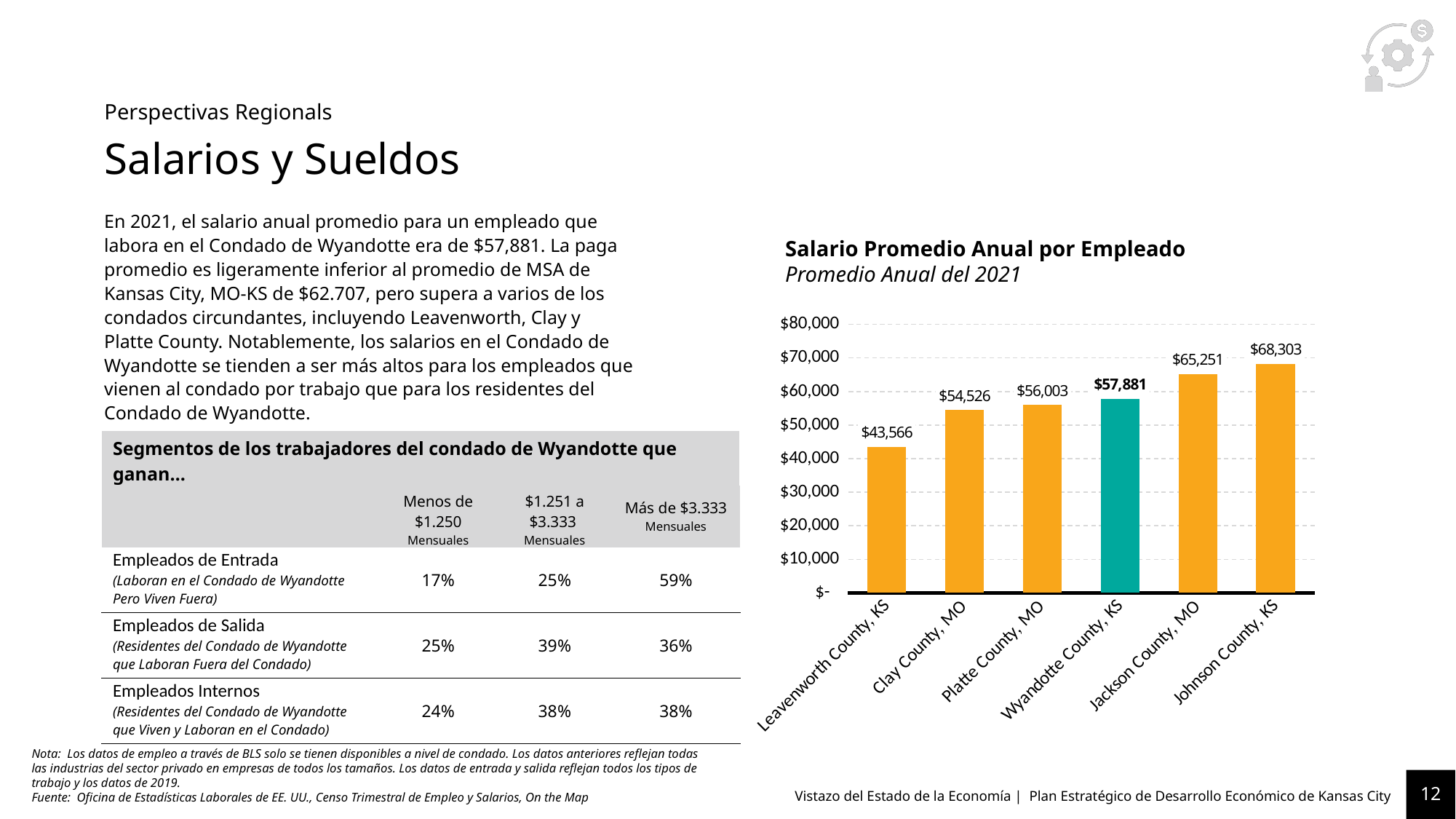
Which county's bar is shown in a different colour (teal) from the others? Wyandotte County, KS What is the average annual salary per employee for Jackson County, MO? $65,251 Is the average annual salary for Leavenworth County, KS greater or less than $50,000? less Which county has the lowest average annual salary per employee? Leavenworth County, KS What is the average annual salary per employee for Wyandotte County, KS? $57,881 How many counties are shown in the chart? 6 Which has a higher average annual salary, Clay County, MO or Jackson County, MO? Jackson County, MO Which county has the highest average annual salary per employee? Johnson County, KS What is the difference between the average annual salary in Platte County, MO and Clay County, MO? $1,477 What is the difference between the average annual salary in Johnson County, KS and Wyandotte County, KS? $10,422 What is the average annual salary per employee for Leavenworth County, KS? $43,566 What type of chart is used to show the average annual salary per employee? Bar chart